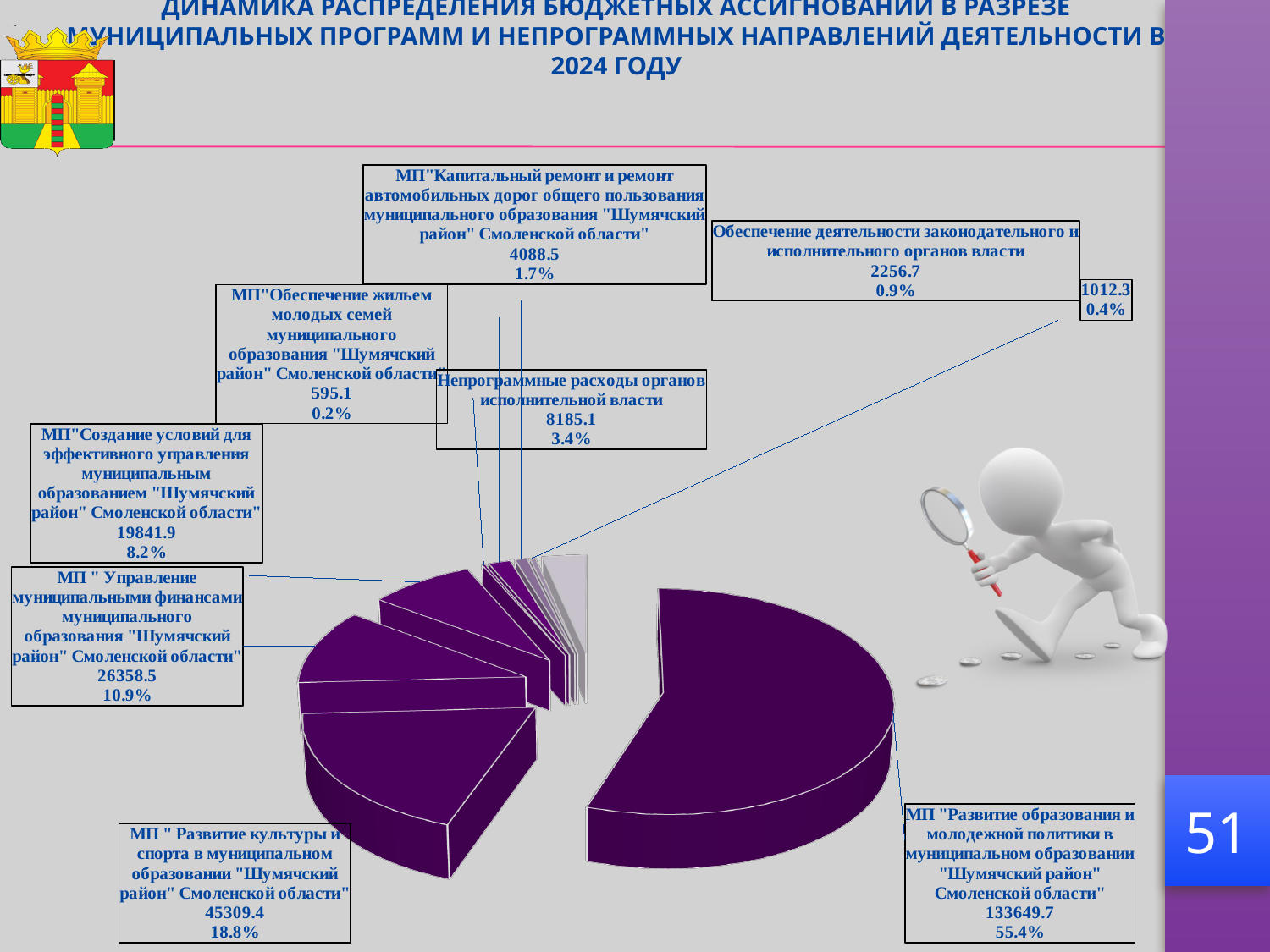
What percentage is shown for МП "Управление муниципальными финансами"? 10.9% What kind of chart is shown on the slide? pie chart What value is shown for Непрограммные расходы органов исполнительной власти? 8185.1 Which is larger: the value for МП "Создание условий для эффективного управления" or for Непрограммные расходы органов исполнительной власти? МП "Создание условий для эффективного управления" What value is shown for МП "Развитие образования и молодежной политики"? 133649.7 What percentage is shown for МП "Обеспечение жильем молодых семей"? 0.2% What is the difference between the values for МП "Развитие культуры и спорта" (45309.4) and МП "Управление муниципальными финансами" (26358.5)? 18950.9 What value is shown for Обеспечение деятельности законодательного и исполнительного органов власти? 2256.7 What value is shown for МП "Развитие культуры и спорта"? 45309.4 Which named category has the smallest value? МП "Обеспечение жильем молодых семей" What share of the pie does МП "Развитие образования и молодежной политики" represent? 55.4% Which category has the largest share of the pie? МП "Развитие образования и молодежной политики"